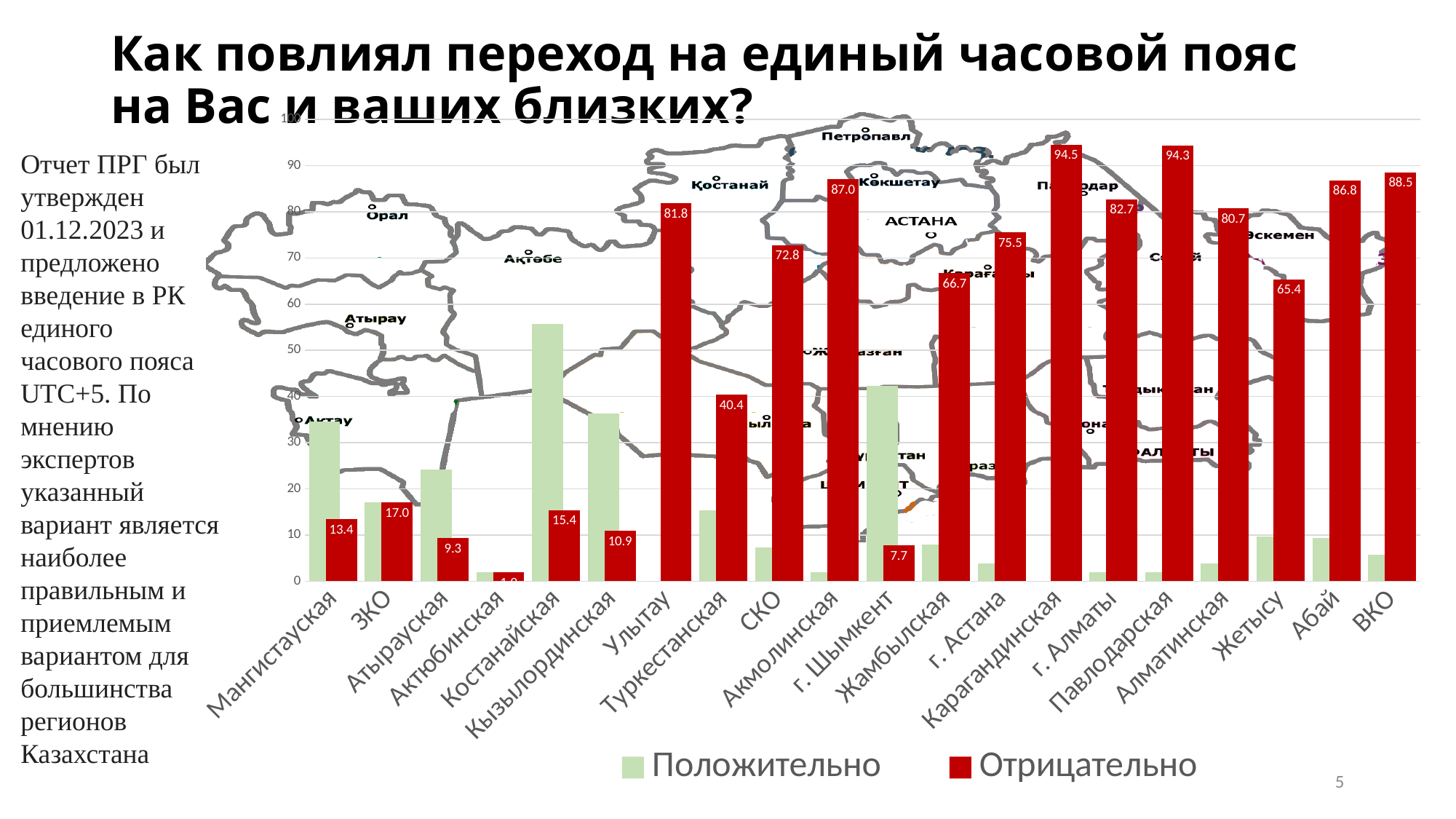
What is the value of the Отрицательно series for Туркестанская? 40.4 What is the value of the Отрицательно series for Жетысу? 65.4 What is the value of the Отрицательно series for ЗКО? 17.0 What is the value of the Отрицательно series for Акмолинская? 87.0 How many regions are shown on the x axis of the chart? 20 What kind of chart is shown on the slide? bar chart Is the Положительно value for Костанайская greater or less than 50? greater Which has a larger Отрицательно value, Улытау or Туркестанская? Улытау What is the difference between the Отрицательно values for Акмолинская and СКО? 14.2 Is the Положительно value for Актюбинская greater or less than 10? less How many series does the legend list? 2 Which region has the highest value in the Отрицательно series? Карагандинская